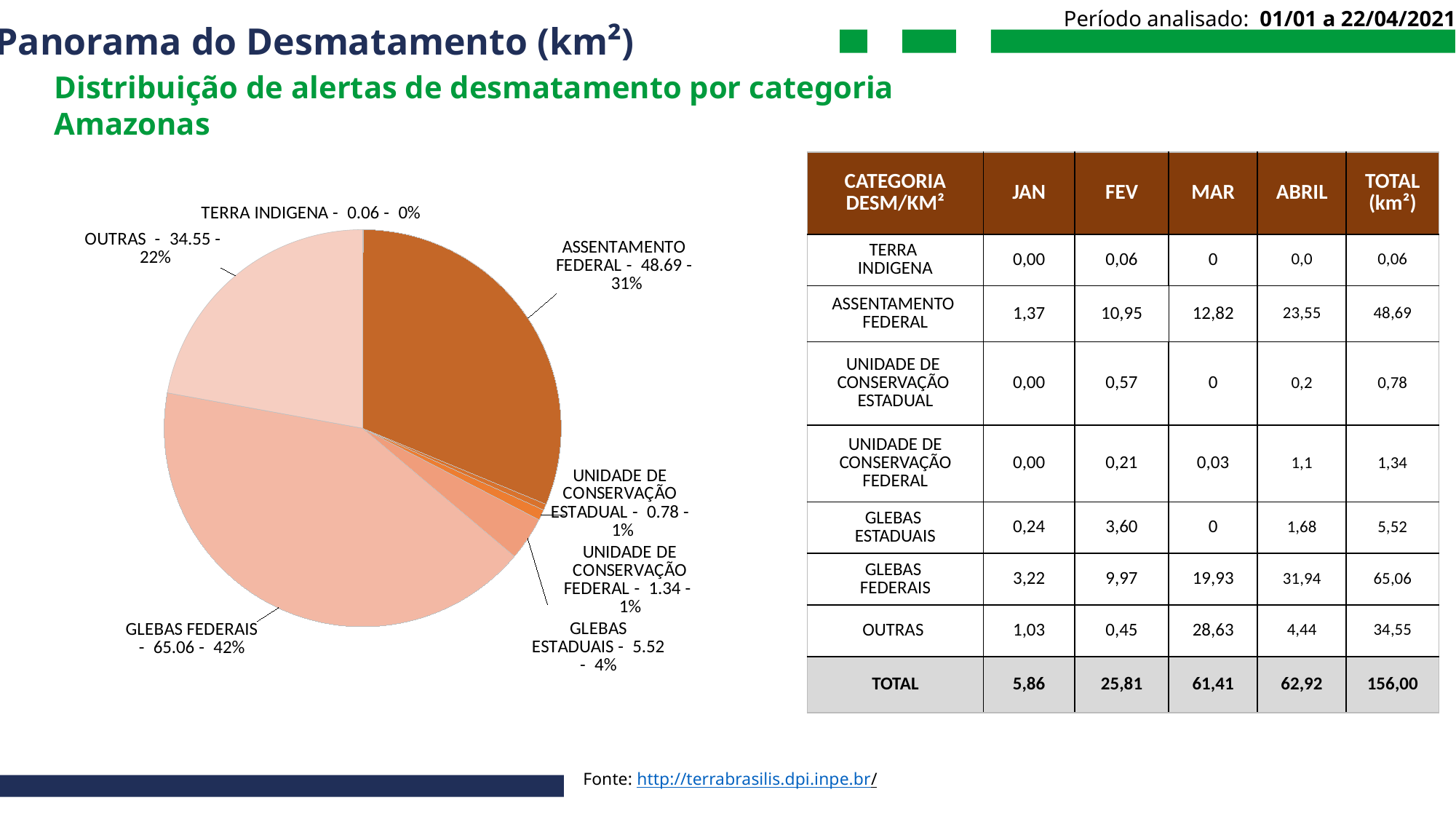
Which category has the smallest slice in the pie chart? TERRA INDIGENA What kind of chart is shown on the slide? pie chart Which is larger in the pie chart, OUTRAS or ASSENTAMENTO FEDERAL? ASSENTAMENTO FEDERAL What percentage share of the pie does GLEBAS FEDERAIS represent? 42% Which category has the largest slice in the pie chart? GLEBAS FEDERAIS What is the value shown for GLEBAS FEDERAIS in the pie chart? 65.06 What is the difference between the values for GLEBAS FEDERAIS and ASSENTAMENTO FEDERAL in the pie chart? 16.37 What percentage share of the pie does OUTRAS represent? 22% What is the value shown for ASSENTAMENTO FEDERAL in the pie chart? 48.69 What is the value shown for GLEBAS ESTADUAIS in the pie chart? 5.52 What is the value shown for OUTRAS in the pie chart? 34.55 How many categories (slices) does the pie chart show? 7